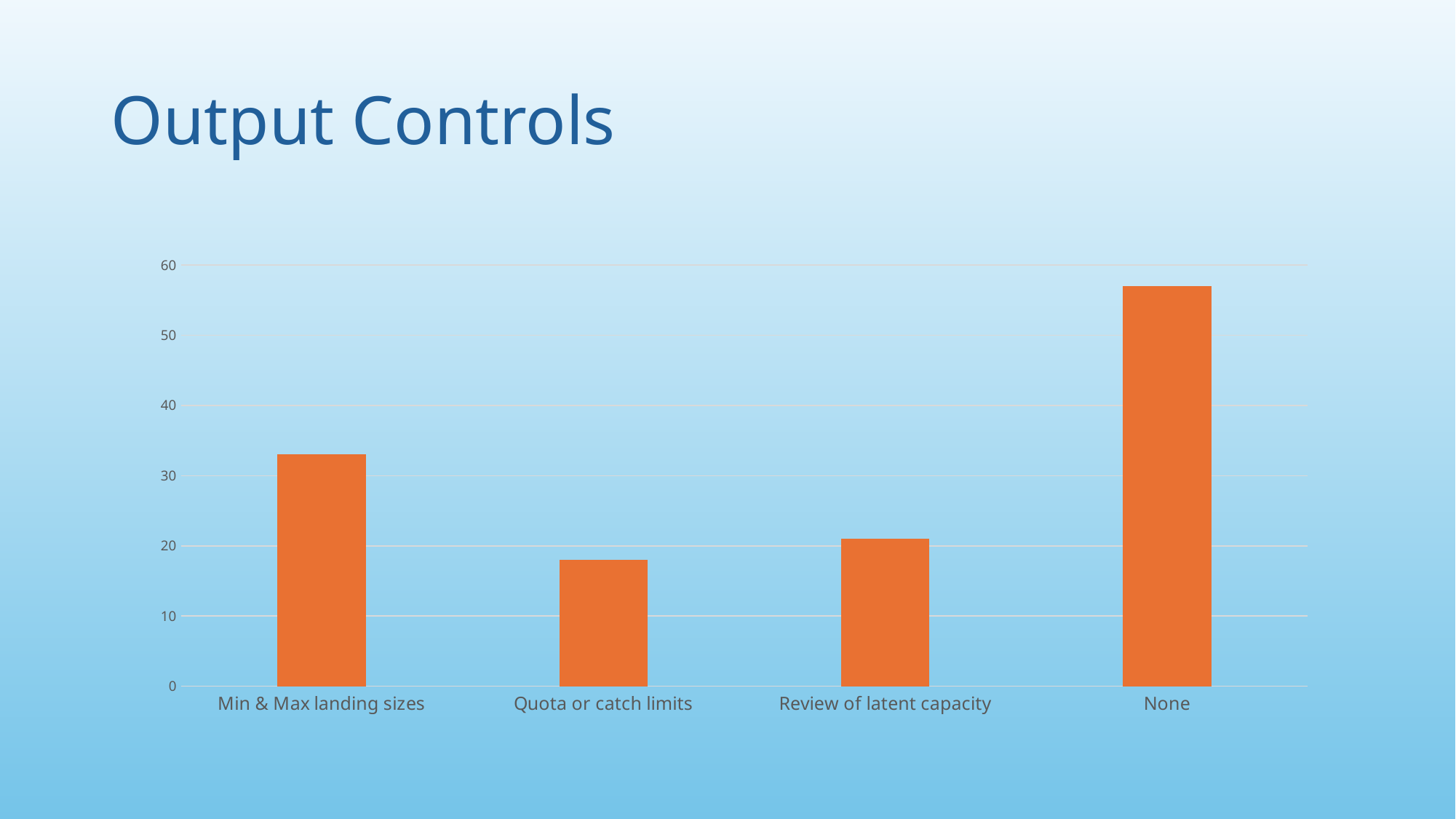
Which is larger, the value for Review of latent capacity or the value for Quota or catch limits? Review of latent capacity How many categories are shown on the x axis of the chart? 4 Is the value for Review of latent capacity greater or less than 30? less Which category has the highest bar? None Which category has the lowest bar? Quota or catch limits What kind of chart is shown on the slide? bar chart Which is larger, the value for Min & Max landing sizes or the value for Review of latent capacity? Min & Max landing sizes What is the title of the slide containing the chart? Output Controls Is the value for None greater or less than 60? less Is the value for None greater or less than 50? greater